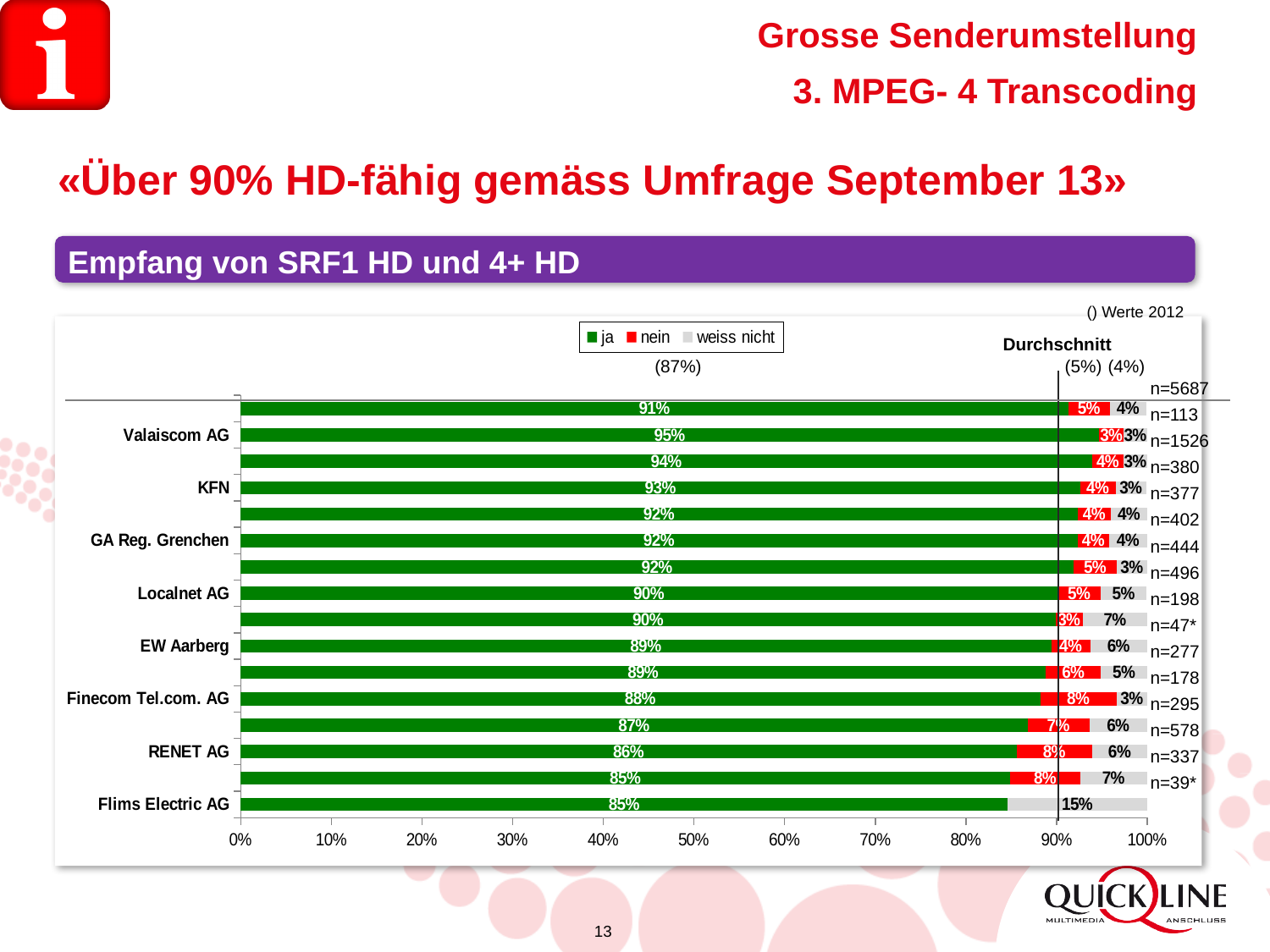
Which labelled provider has the highest "weiss nicht" share? Flims Electric AG Which labelled provider has the highest "ja" share? Valaiscom AG Do the "ja" values rise or fall going from the top bar to the bottom bar? Fall How many series does the legend list? 3 Which has a higher "ja" value, KFN or Localnet AG? KFN What is the "weiss nicht" value for Flims Electric AG? 15% What kind of chart is shown on the slide? Stacked horizontal bar chart What is the "nein" value for Finecom Tel.com. AG? 8% What is the "weiss nicht" value for EW Aarberg? 6% What is the difference in percentage points between the "ja" values of Valaiscom AG and RENET AG? 9 percentage points What is the "ja" value for Valaiscom AG? 95% What are the three legend entries of the chart? ja, nein, weiss nicht